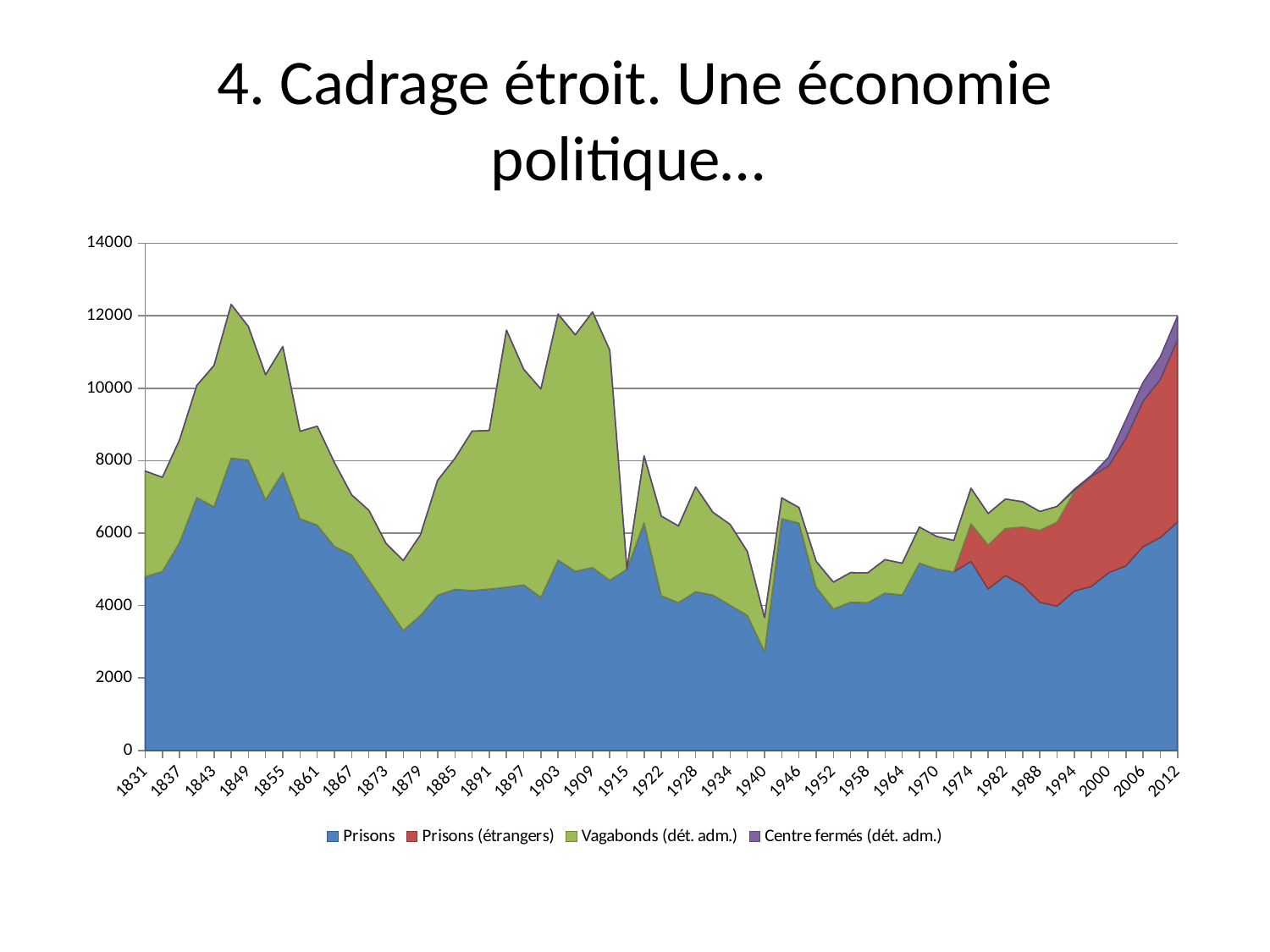
Is the value for Prisons around 1879 greater or less than 4000? less What is the highest value shown on the vertical axis? 14000 Which series is shown in green in the legend? Vagabonds (dét. adm.) What kind of chart is shown on the slide? Stacked area chart What is the first year shown on the horizontal axis? 1831 How many series does the legend list? 4 Which series is shown in red in the legend? Prisons (étrangers) What is the last year shown on the horizontal axis? 2012 Is the total stacked value around 1849 larger or smaller than the total around 1940? larger Is the total stacked value around 1849 greater or less than 10000? greater Is the total stacked value around 1940 greater or less than 4000? less Does the total stacked value rise or fall between 1994 and 2012? rise